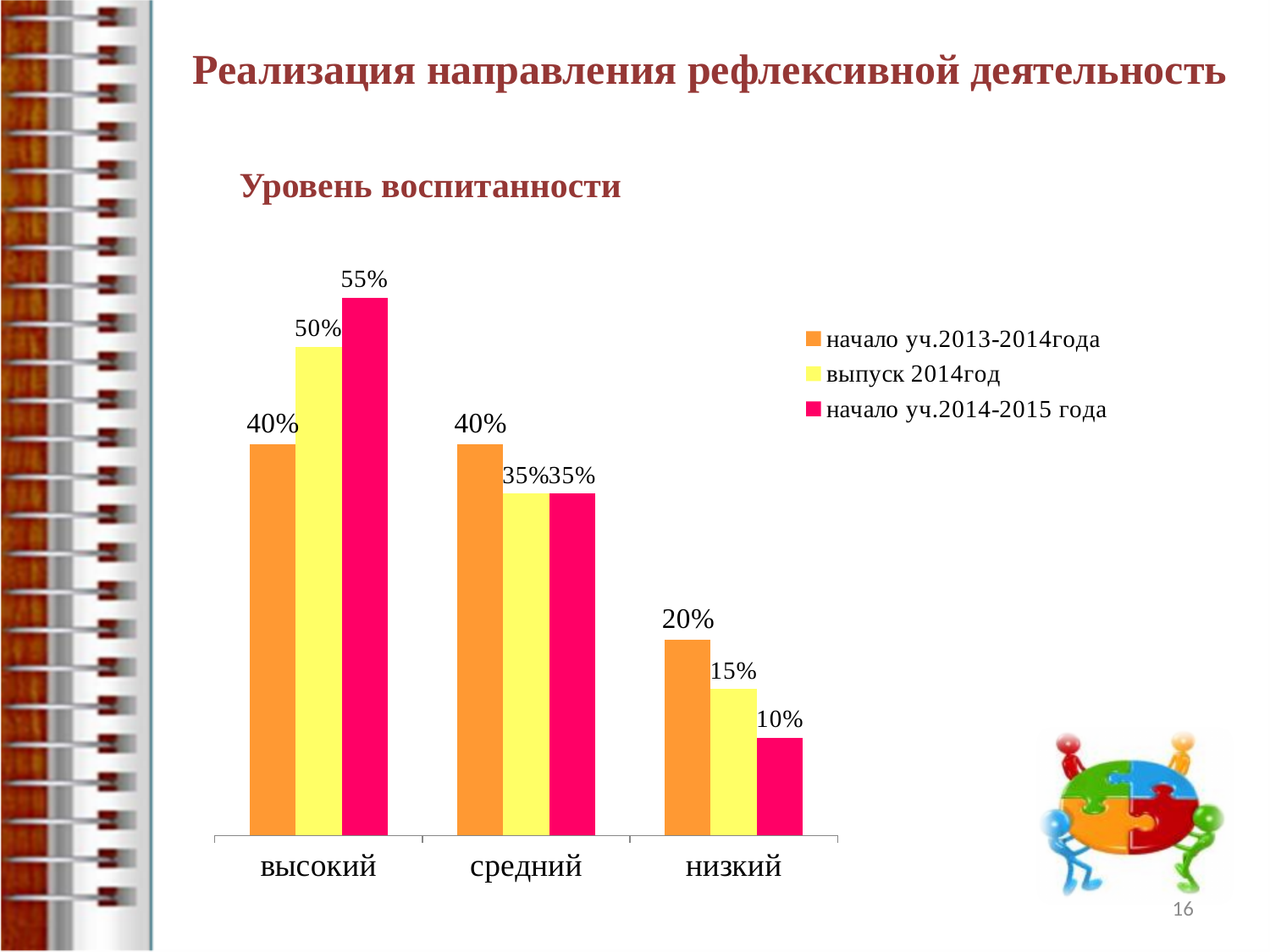
How many categories are shown on the x axis? 3 What is the value for низкий in the series выпуск 2014год? 15% What is the value for средний in the series начало уч.2013-2014года? 40% Which is larger for the category низкий: the value for начало уч.2013-2014года or for начало уч.2014-2015 года? начало уч.2013-2014года Which category has the lowest value in the series начало уч.2013-2014года? низкий What kind of chart is shown on the slide? bar chart What is the value for низкий in the series начало уч.2014-2015 года? 10% What is the value for высокий in the series начало уч.2014-2015 года? 55% What is the difference between the высокий values for начало уч.2014-2015 года and начало уч.2013-2014года? 15% Do the values for the series начало уч.2014-2015 года rise or fall from высокий to низкий? fall How many series does the legend list? 3 Which category has the highest value in the series начало уч.2014-2015 года? высокий